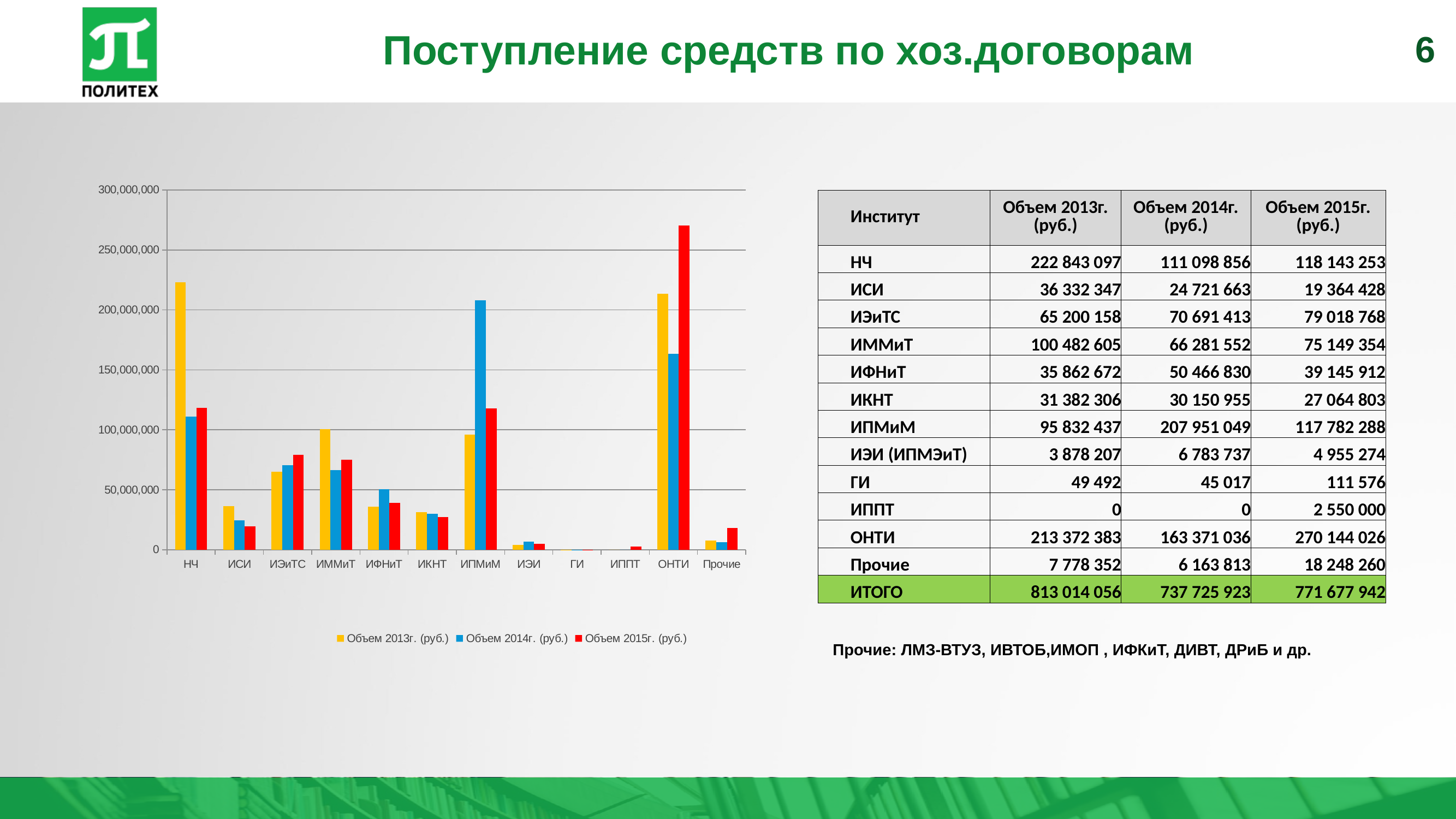
Which category has the lowest value for Объем 2013г. (руб.)? ИППТ Which category has the highest value for Объем 2013г. (руб.)? НЧ Which category has the highest value for Объем 2015г. (руб.)? ОНТИ Is the value for ИЭиТС in Объем 2013г. (руб.) greater or less than 100,000,000? less Is the value for ОНТИ in Объем 2015г. (руб.) greater or less than 250,000,000? greater What colour are the bars for Объем 2015г. (руб.) in the chart? red How many categories are shown on the x axis of the chart? 12 What kind of chart is shown on the slide? bar chart Which is larger for НЧ: Объем 2013г. (руб.) or Объем 2014г. (руб.)? Объем 2013г. (руб.) Which category has the highest value for Объем 2014г. (руб.)? ИПМиМ How many series does the chart legend list? 3 Which is larger for ИПМиМ: Объем 2014г. (руб.) or Объем 2015г. (руб.)? Объем 2014г. (руб.)